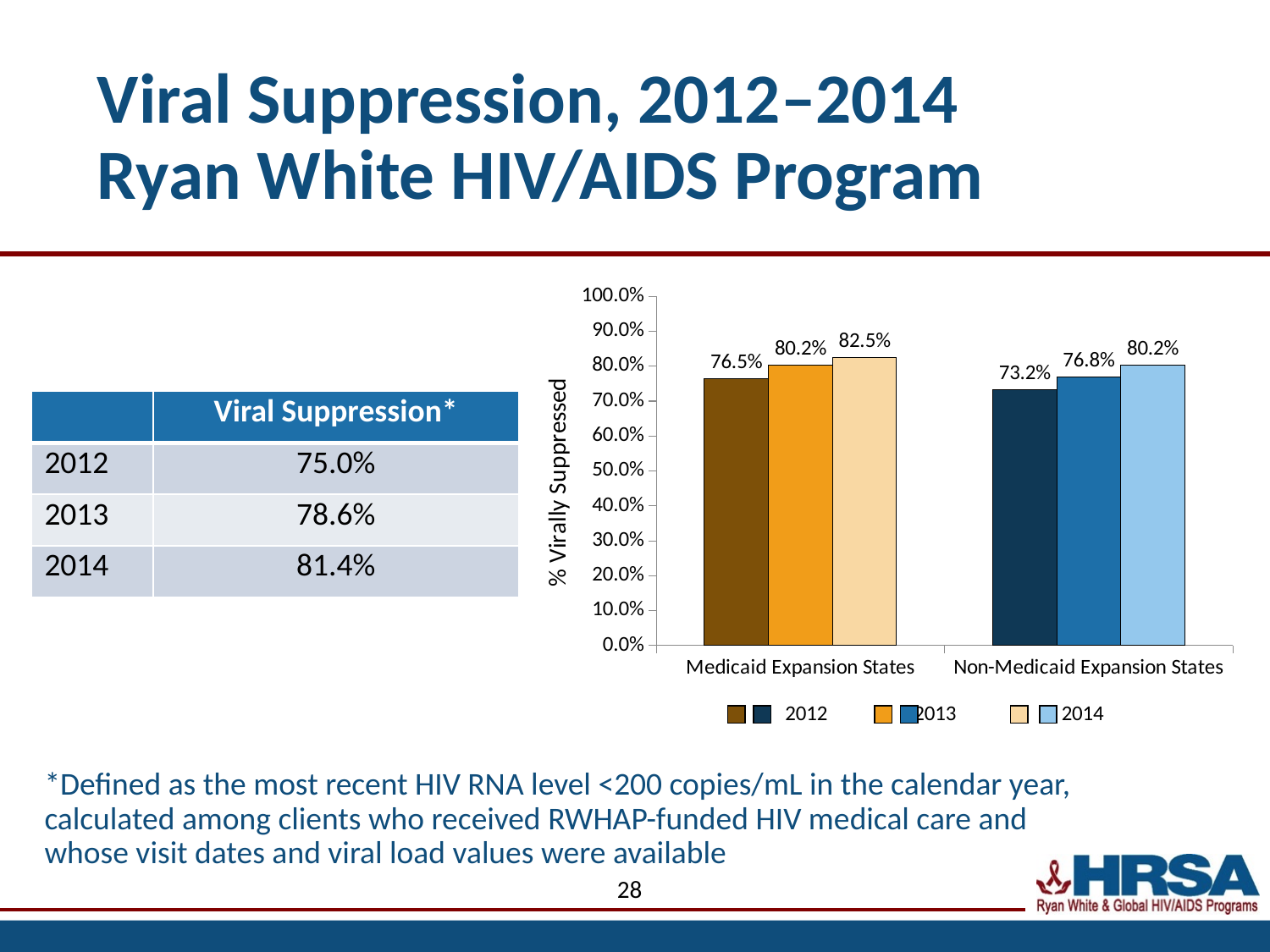
Which bar in the chart has the highest value? Medicaid Expansion States, 2014 (82.5%) Is the 2012 value for Non-Medicaid Expansion States greater or less than 80.0%? less Do the values for Medicaid Expansion States rise or fall from 2012 to 2014? rise What is the value for Non-Medicaid Expansion States in 2014? 80.2% Which bar in the chart has the lowest value? Non-Medicaid Expansion States, 2012 (73.2%) What is the value for Medicaid Expansion States in 2012? 76.5% What kind of chart is shown on the slide? bar chart What is the value for Non-Medicaid Expansion States in 2013? 76.8% What is the difference between the 2014 values for Medicaid Expansion States and Non-Medicaid Expansion States? 2.3% Which is larger: the 2013 value for Medicaid Expansion States or the 2013 value for Non-Medicaid Expansion States? Medicaid Expansion States What is the label on the vertical axis of the chart? % Virally Suppressed How many series does the legend list? 3